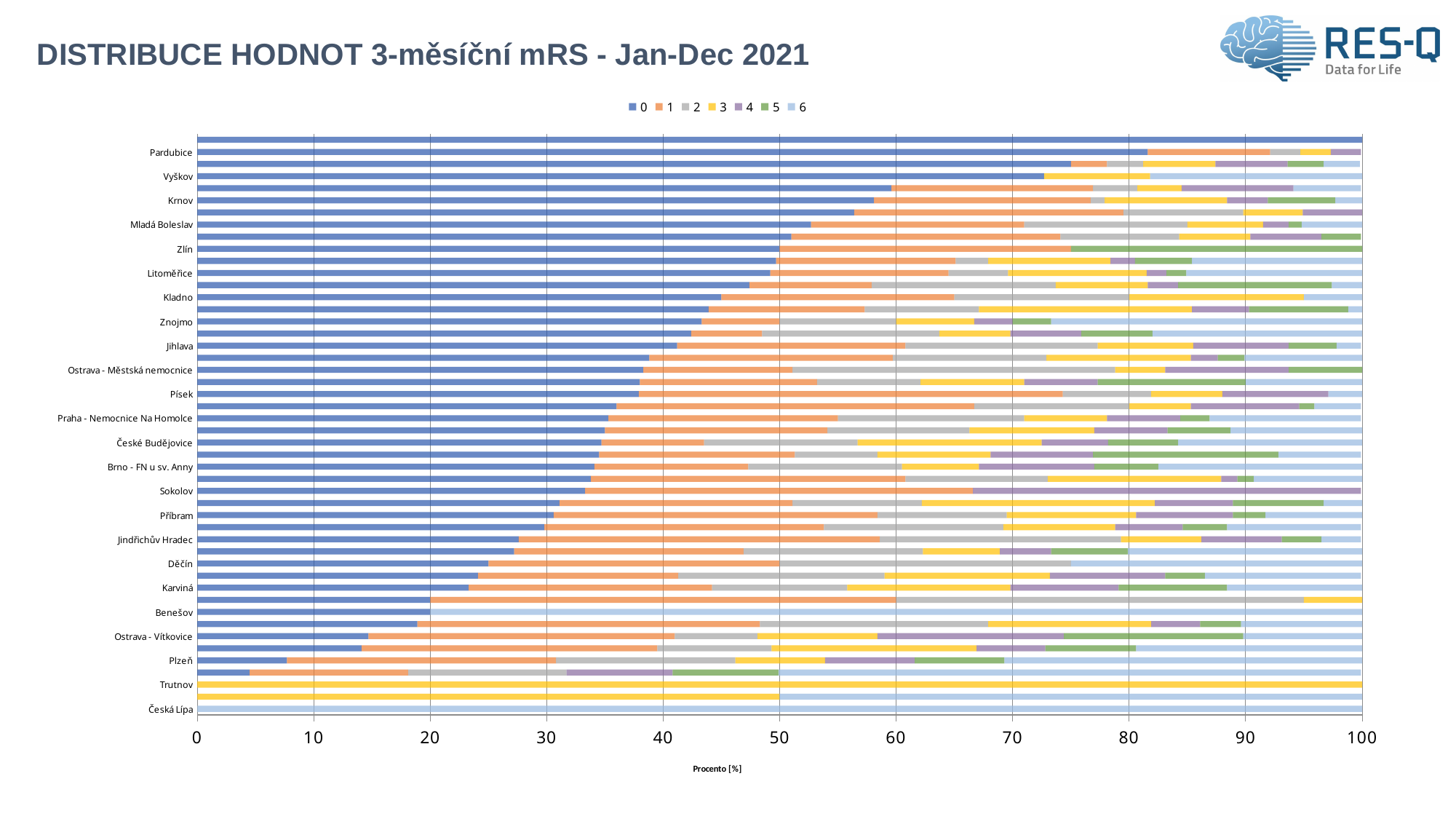
What is the value of series 6 for Česká Lípa? 100 Which has the larger value of series 0, Krnov or Kladno? Krnov What is the title of the x axis? Procento [%] How many series does the legend list? 7 Is the value of series 0 for Plzeň greater or less than 10? less What is the value of series 3 for Trutnov? 100 What kind of chart is shown on the slide? stacked bar chart Does the share of series 0 generally decrease or increase going from the top bar to the bottom bar? decrease Is the value of series 0 for Vyškov greater or less than 70? greater Is the value of series 0 for Kladno greater or less than 50? less What are the legend entries of the chart? 0, 1, 2, 3, 4, 5, 6